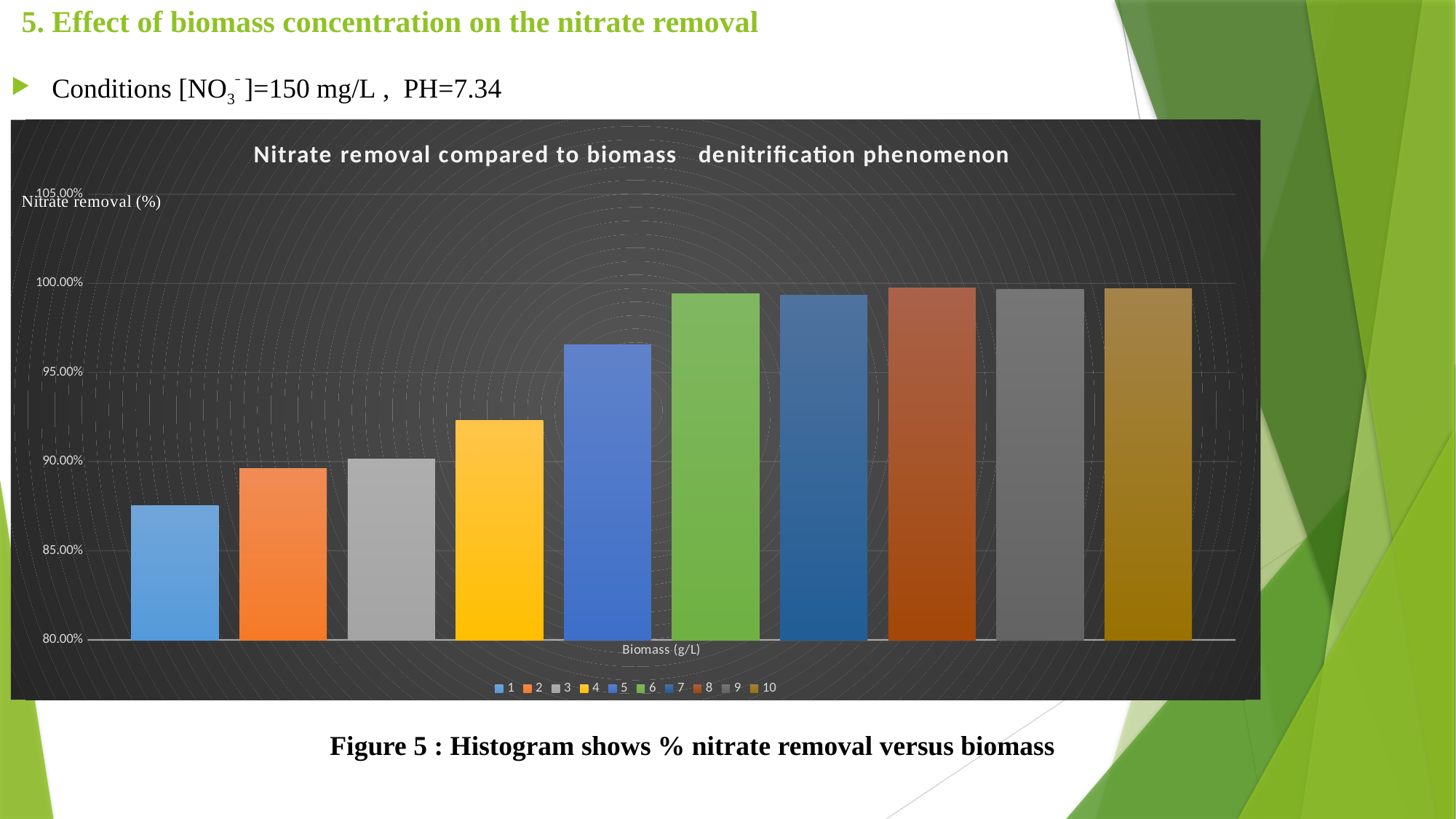
Is the value for bar 2 greater or less than 90.00%? less How many bars are plotted in the chart? 10 Is the value for bar 5 greater or less than 95.00%? greater What is the label of the x axis of the chart? Biomass (g/L) Which bar has the lowest nitrate removal value? 1 Is the value for bar 4 greater or less than 90.00%? greater What is the title of the chart? Nitrate removal compared to biomass denitrification phenomenon How many entries does the chart legend list? 10 Do the nitrate removal values generally rise or fall from left to right along the x axis? rise What kind of chart is shown on the slide? bar chart Which is larger, the value for bar 4 or the value for bar 5? 5